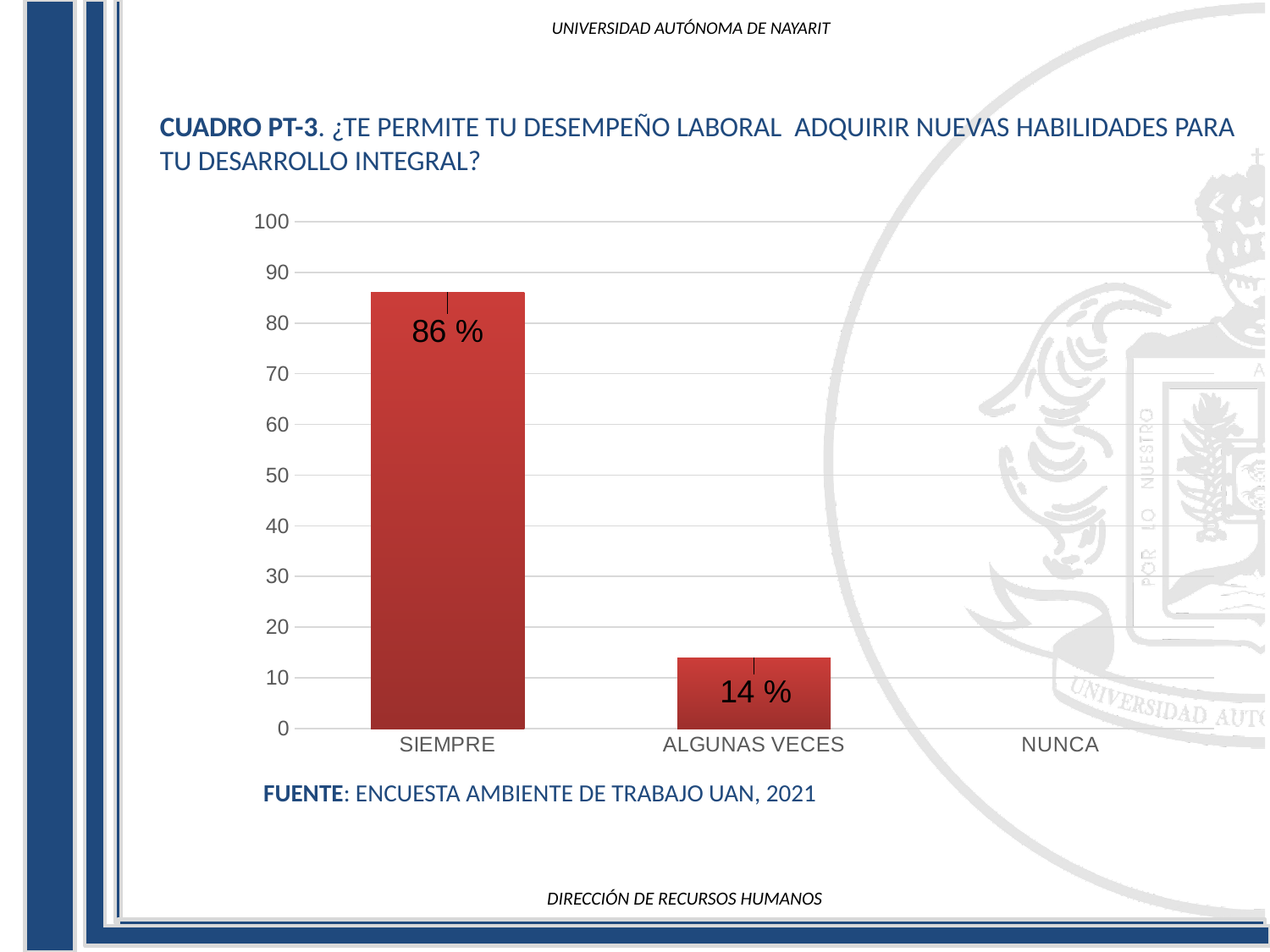
What kind of chart is shown on the slide? Bar chart Do the values rise or fall from left to right along the x axis? Fall What is the source cited below the chart? ENCUESTA AMBIENTE DE TRABAJO UAN, 2021 What is the difference between the values for SIEMPRE and ALGUNAS VECES? 72 % Is the value for SIEMPRE greater or less than 80? greater Is the value for ALGUNAS VECES greater or less than 20? less What is the value shown for SIEMPRE? 86 % How many categories are shown on the x axis? 3 Which category has the highest value? SIEMPRE What is the value shown for ALGUNAS VECES? 14 % Which is larger, the value for SIEMPRE or the value for ALGUNAS VECES? SIEMPRE